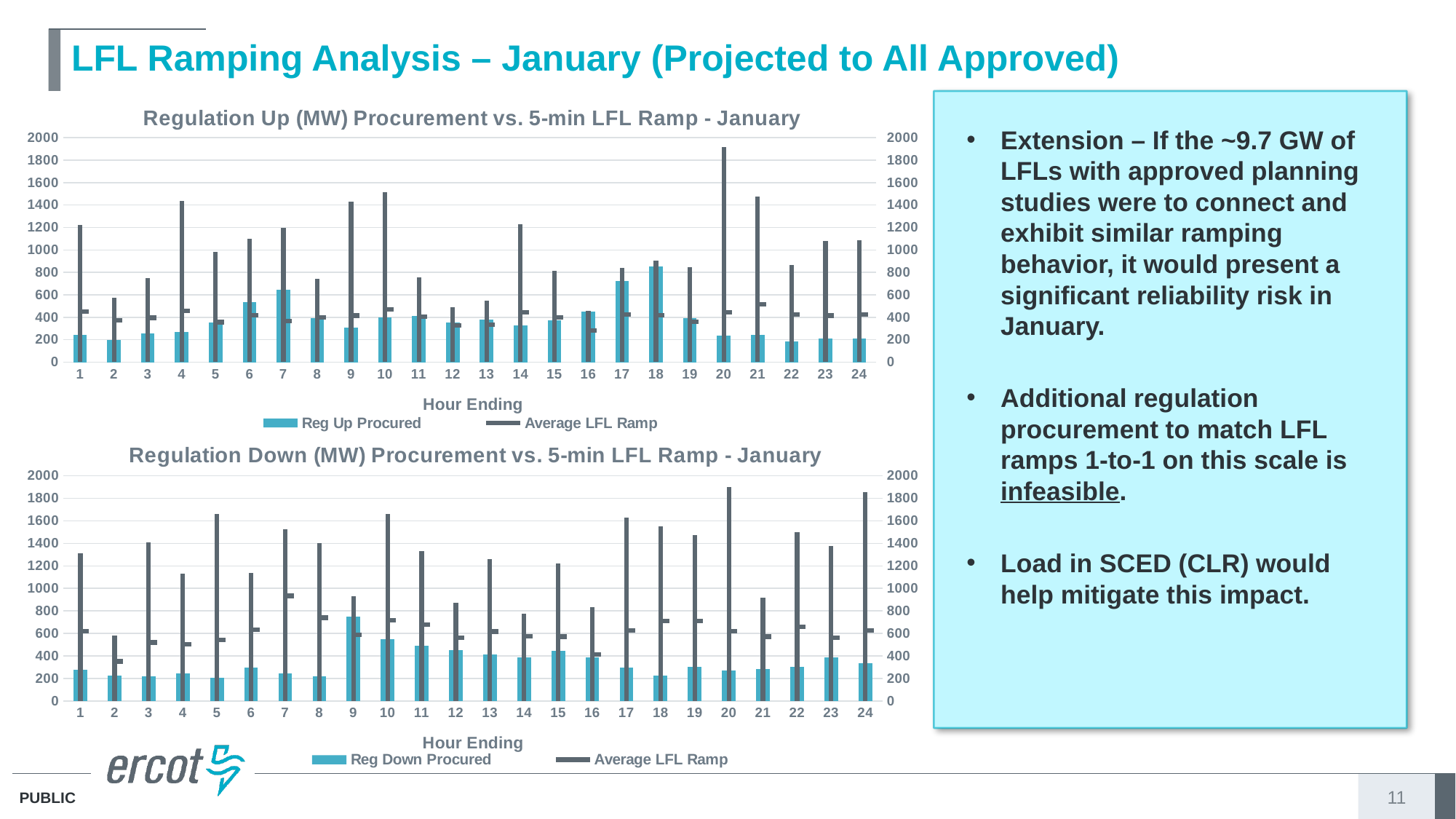
In the top chart (Regulation Up), which is larger, the Reg Up Procured value for hour 7 or for hour 1? Hour 7 In the bottom chart (Regulation Down), is the Average LFL Ramp value for hour 5 greater or less than 1400? less What kind of chart is the top chart (Regulation Up)? Bar chart In the top chart (Regulation Up), which hour has the highest Reg Up Procured value? 18 What is the x-axis title of the bottom chart (Regulation Down)? Hour Ending In the top chart (Regulation Up), which hour has the highest Average LFL Ramp value? 21 In the bottom chart (Regulation Down), how many series does the legend list? 2 In the bottom chart (Regulation Down), which hour has the highest Reg Down Procured value? 9 What is the title of the top chart on the slide? Regulation Up (MW) Procurement vs. 5-min LFL Ramp - January In the top chart (Regulation Up), is the Reg Up Procured value for hour 1 greater or less than 400? less In the top chart (Regulation Up), is the Reg Up Procured value for hour 18 greater or less than 800? greater In the top chart (Regulation Up), how many hours are shown on the x axis? 24